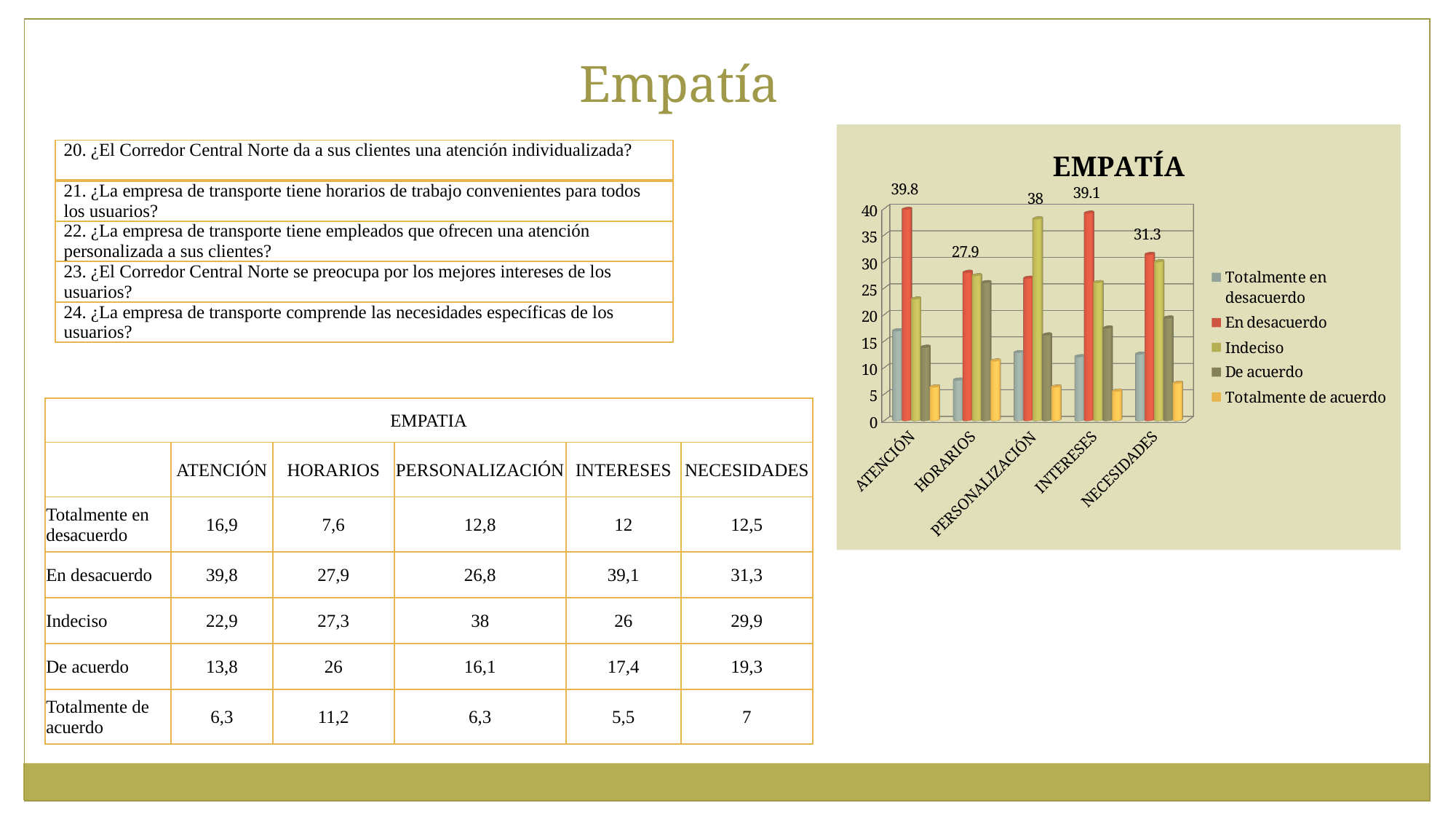
What is the labelled value of the En desacuerdo bar for INTERESES in the EMPATÍA chart? 39.1 In the EMPATÍA chart, which category has the higher En desacuerdo value, ATENCIÓN or HORARIOS? ATENCIÓN In the EMPATÍA chart, is the De acuerdo value for HORARIOS greater or less than 20? greater What kind of chart is shown on the slide? bar chart What is the labelled value of the Indeciso bar for PERSONALIZACIÓN in the EMPATÍA chart? 38 How many categories are shown on the x axis of the EMPATÍA chart? 5 What is the labelled value of the En desacuerdo bar for NECESIDADES in the EMPATÍA chart? 31.3 What is the labelled value of the En desacuerdo bar for ATENCIÓN in the EMPATÍA chart? 39.8 In the EMPATÍA chart, what is the difference between the labelled En desacuerdo values for ATENCIÓN and HORARIOS? 11.9 What is the title of the chart on the slide? EMPATÍA In the EMPATÍA chart, which category has the highest En desacuerdo value? ATENCIÓN How many series does the legend of the EMPATÍA chart list? 5